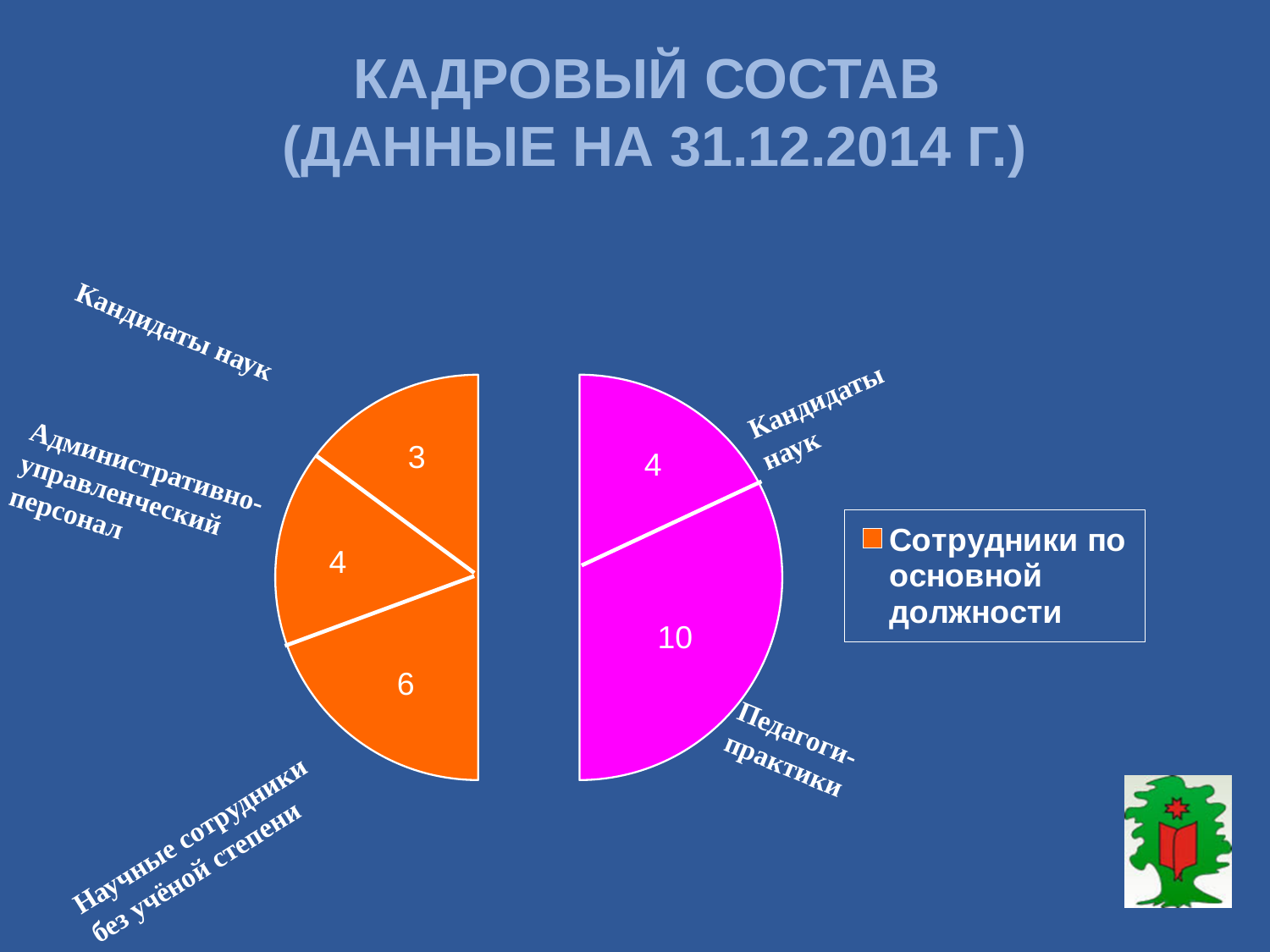
What is the value of the orange slice labelled Кандидаты наук? 3 What is the value of the slice labelled Научные сотрудники без учёной степени? 6 What kind of chart is shown on the slide? pie chart What is the difference between the Педагоги-практики slice and the Научные сотрудники без учёной степени slice? 4 What is the value of the magenta slice labelled Кандидаты наук? 4 Which slice has the largest value in the pie chart? Педагоги-практики Which is larger: the Научные сотрудники без учёной степени slice or the Административно-управленческий персонал slice? Научные сотрудники без учёной степени What is the value of the slice labelled Педагоги-практики? 10 What is the value of the slice labelled Административно-управленческий персонал? 4 Which slice has the smallest value in the pie chart? Кандидаты наук (orange, 3) What is the legend entry shown next to the pie chart? Сотрудники по основной должности How many slices does the pie chart have in total? 5